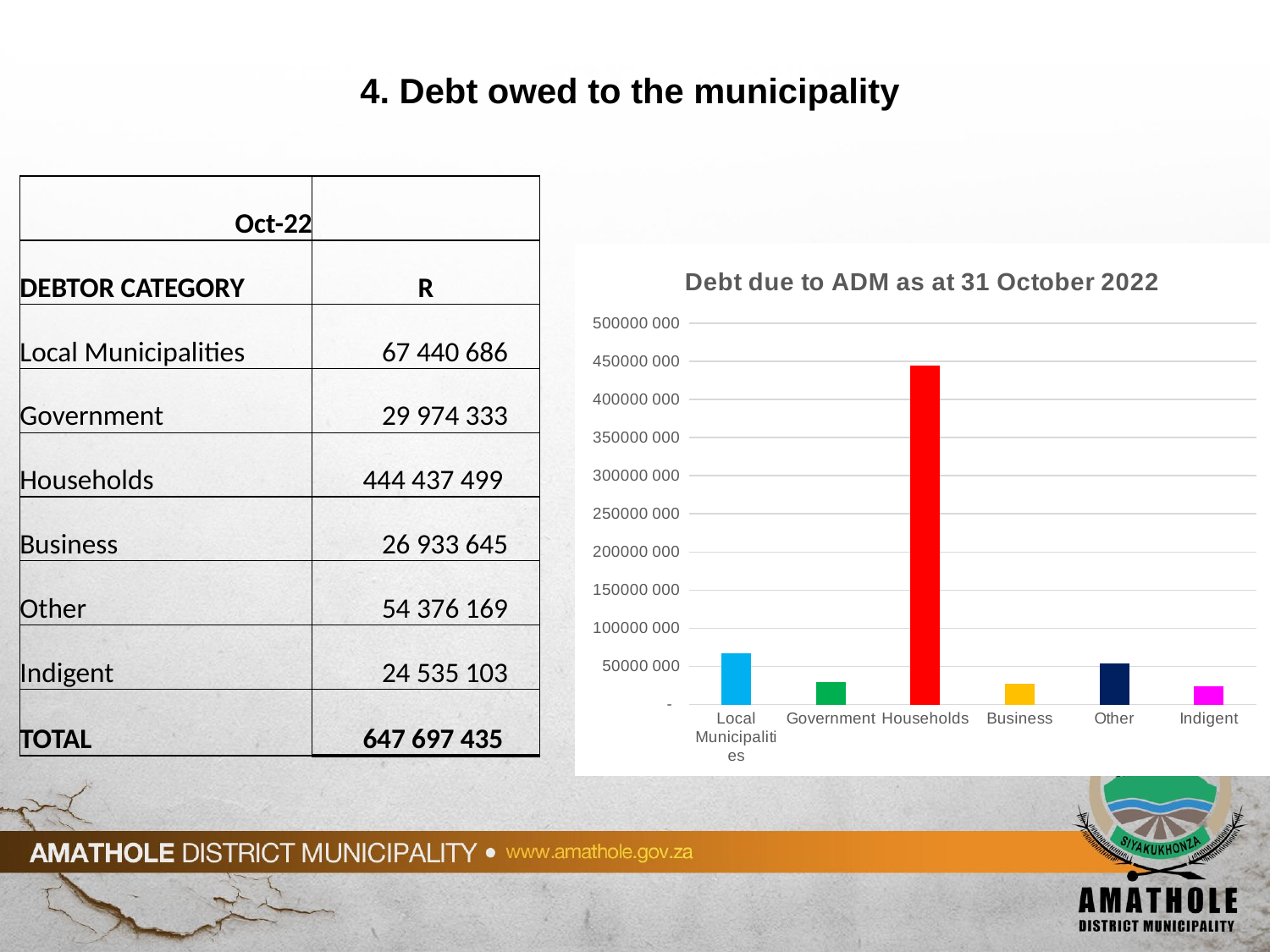
What is the difference between the debt for Households and the debt for Local Municipalities? 376 996 813 What is the title of the chart? Debt due to ADM as at 31 October 2022 Is the value for Government greater or less than 50000 000? less Which is larger, the debt for Local Municipalities or the debt for Other? Local Municipalities Which debtor category has the lowest debt? Indigent What is the debt value for Local Municipalities? 67 440 686 Is the value for Households greater or less than 400000 000? greater Which debtor category has the highest debt in the chart? Households What type of chart is shown on the slide? bar chart What is the debt value for Other? 54 376 169 What is the debt value for Households? 444 437 499 How many debtor categories are plotted in the chart? 6